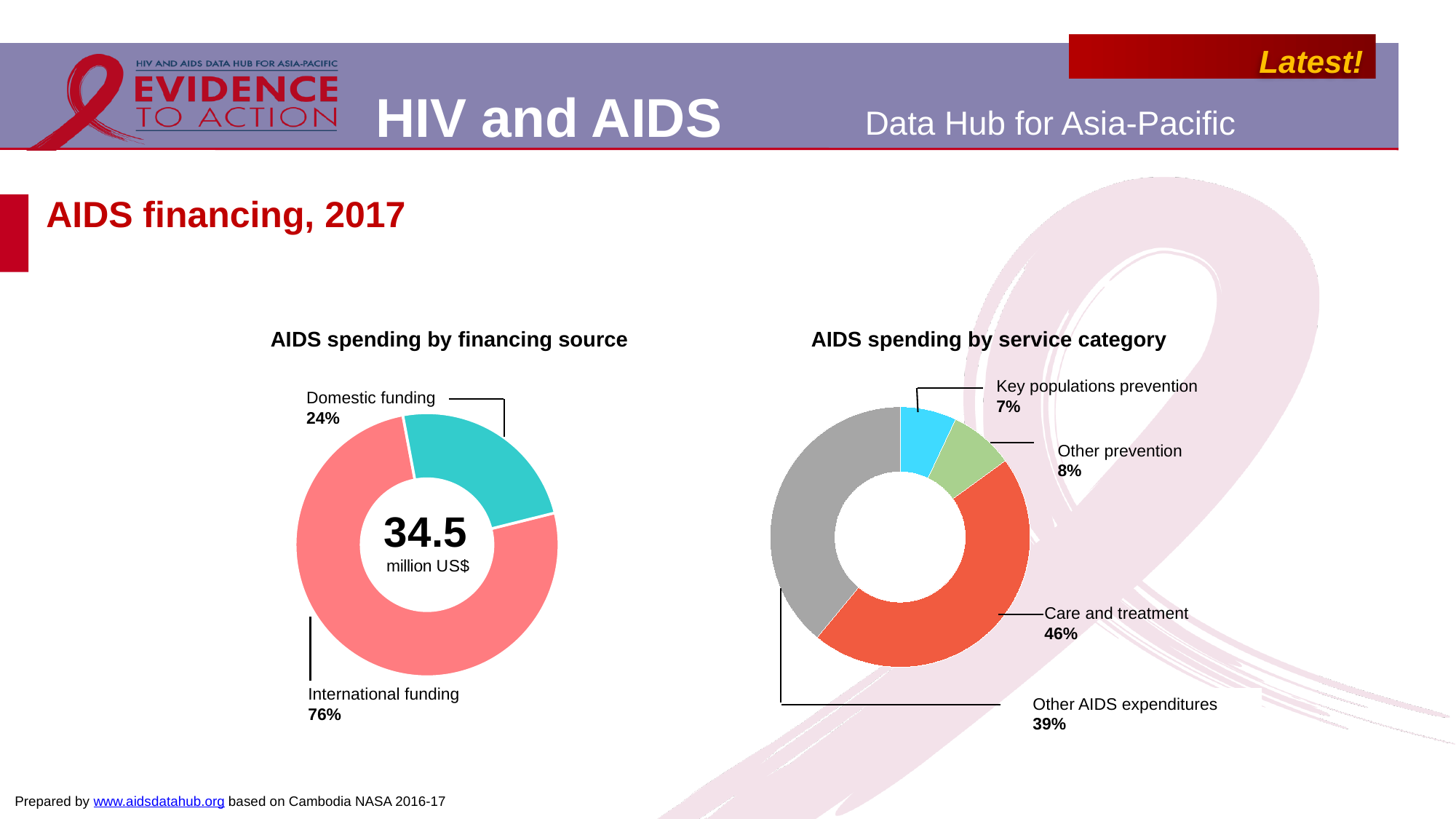
In the 'AIDS spending by service category' chart, what is the combined share of Key populations prevention and Other prevention? 15% In the 'AIDS spending by financing source' chart, what is the difference in percentage points between International funding and Domestic funding? 52 percentage points In the 'AIDS spending by service category' chart, how many service categories are shown? 4 In the 'AIDS spending by financing source' chart, what share is Domestic funding? 24% In the 'AIDS spending by service category' chart, what share is Key populations prevention? 7% What type of chart is used for 'AIDS spending by financing source'? Donut (pie) chart In the 'AIDS spending by financing source' chart, what share is International funding? 76% In the 'AIDS spending by financing source' chart, what total amount is shown in the centre of the donut? 34.5 million US$ In the 'AIDS spending by service category' chart, which service category has the smallest share? Key populations prevention In the 'AIDS spending by financing source' chart, which financing source has the larger share? International funding In the 'AIDS spending by service category' chart, what share is Other AIDS expenditures? 39% In the 'AIDS spending by service category' chart, what share is Care and treatment? 46%